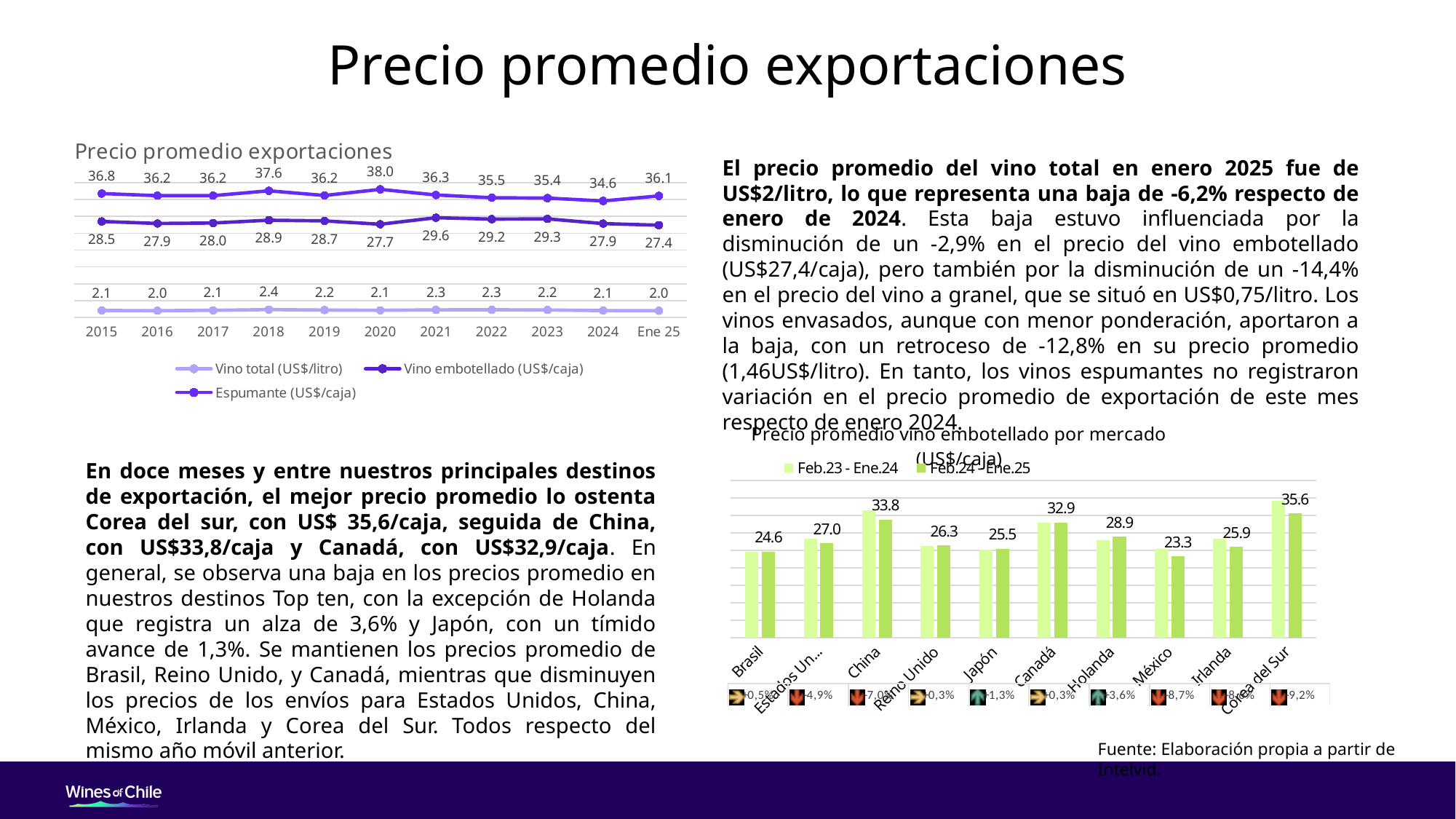
How many markets are shown on the x axis of the 'Precio promedio vino embotellado por mercado' bar chart? 10 In the 'Precio promedio exportaciones' line chart, which period has the lowest value for Vino embotellado (US$/caja)? Ene 25 In the 'Precio promedio exportaciones' line chart, what is the value of Espumante (US$/caja) in 2020? 38.0 In the 'Precio promedio exportaciones' line chart, in which year does Espumante (US$/caja) reach its highest value? 2020 In the 'Precio promedio exportaciones' line chart, what is the value of Vino embotellado (US$/caja) for Ene 25? 27.4 What kind of chart is the 'Precio promedio exportaciones' chart on the left? Line chart In the 'Precio promedio exportaciones' line chart, is the Vino embotellado value higher in 2015 or in 2021? 2021 In the 'Precio promedio vino embotellado por mercado' bar chart, what data label is shown for China? 33.8 In the 'Precio promedio exportaciones' line chart, what is the difference between the Espumante values in 2020 and 2024? 3.4 How many series does the legend of the 'Precio promedio exportaciones' line chart list? 3 In the 'Precio promedio vino embotellado por mercado' bar chart, which market has the highest labelled value? Corea del Sur In the 'Precio promedio exportaciones' line chart, what is the value of Vino total (US$/litro) in 2018? 2.4